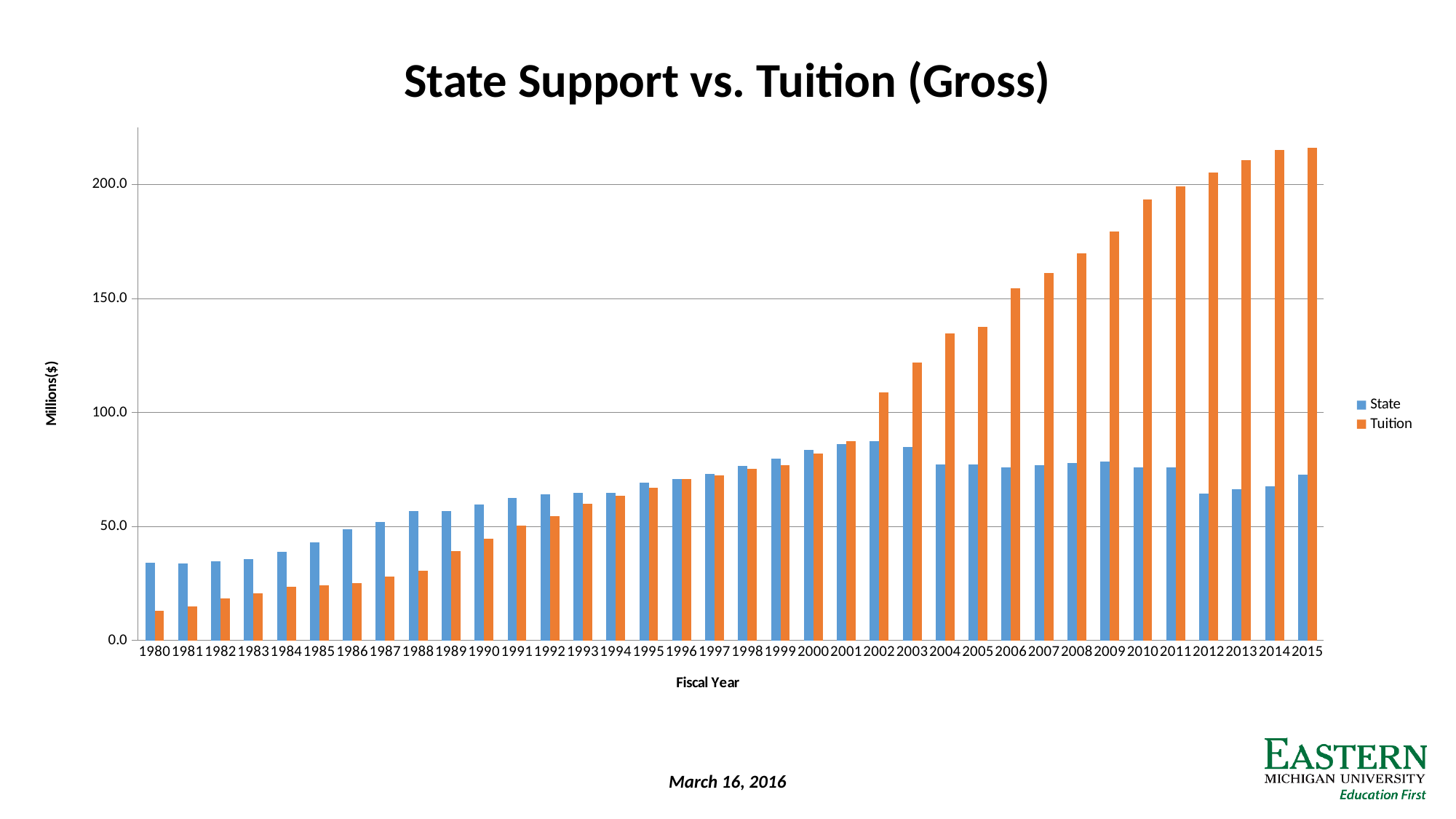
Is the Tuition value for 2003 greater or less than 100.0? greater Is the Tuition value for 2015 greater or less than 200.0? greater In 2015, which is larger, State or Tuition? Tuition Is the State value for 2015 greater or less than 50.0? greater What is the label on the y axis? Millions($) Do the Tuition values generally rise or fall from 1980 to 2015? rise How many fiscal years are shown on the x axis? 36 How many series does the legend list? 2 In 1980, which is larger, State or Tuition? State Which fiscal year has the lowest Tuition value? 1980 What type of chart is shown on the slide? bar chart